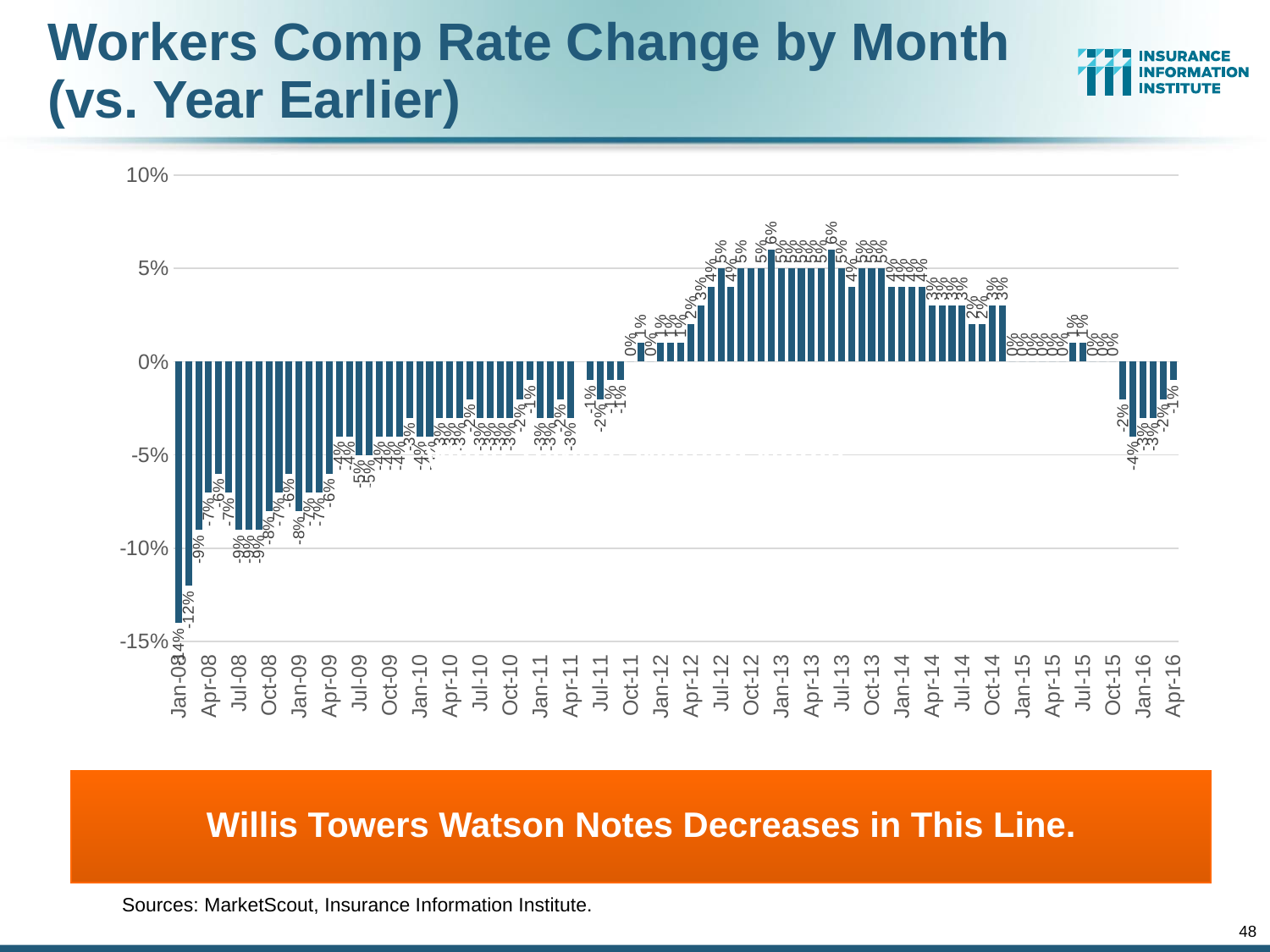
What is the difference between the rate change for Apr-16 (-1%) and Jan-08 (-14%)? 13 percentage points What is the title of the chart? Workers Comp Rate Change by Month (vs. Year Earlier) What is the rate change for Apr-16, the last bar on the chart? -1% Is the value for Jan-09 greater or less than -5%? less Which month has the lowest rate change on the chart? Jan-08 Do the values generally rise or fall from Jan-08 to Jan-13? rise Is the value for Jan-13 greater or less than 0%? greater What is the highest value shown on the chart? 6% What is the lowest value shown on the chart? -14% What kind of chart is shown on the slide? bar chart Which is larger, the rate change for Jan-13 or for Jan-09? Jan-13 What is the rate change for Jan-15? 0%